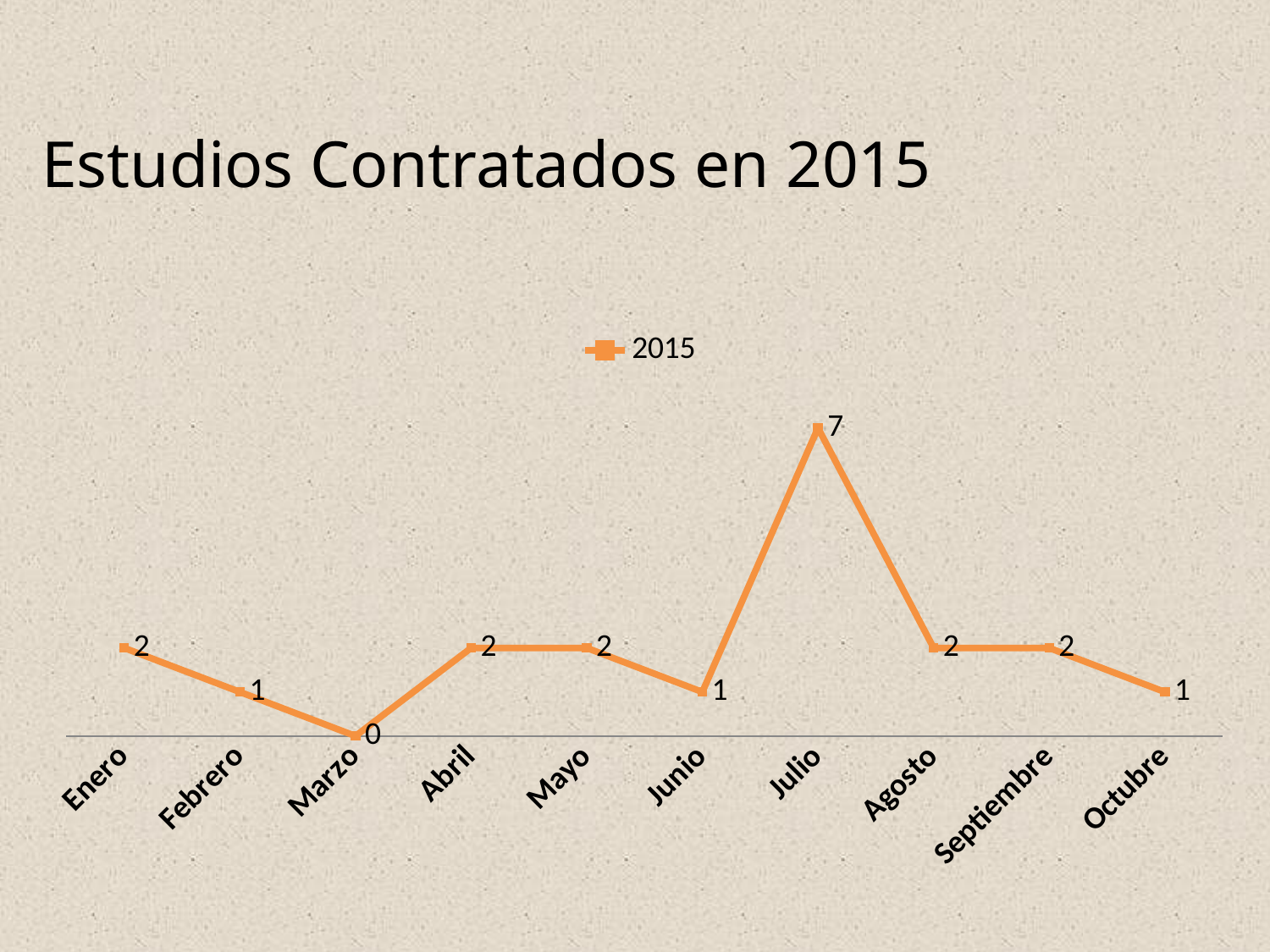
What is the title of the slide? Estudios Contratados en 2015 Which month has the highest value? Julio Which is larger, the value for Febrero or the value for Abril? Abril What is the value for Julio? 7 What is the value for Octubre? 1 How many months are plotted on the x axis? 10 What kind of chart is shown? Line chart Which month has the lowest value? Marzo What is the value for Enero? 2 How many series does the legend list? 1 What is the value for Marzo? 0 What is the difference between the values for Julio and Agosto? 5